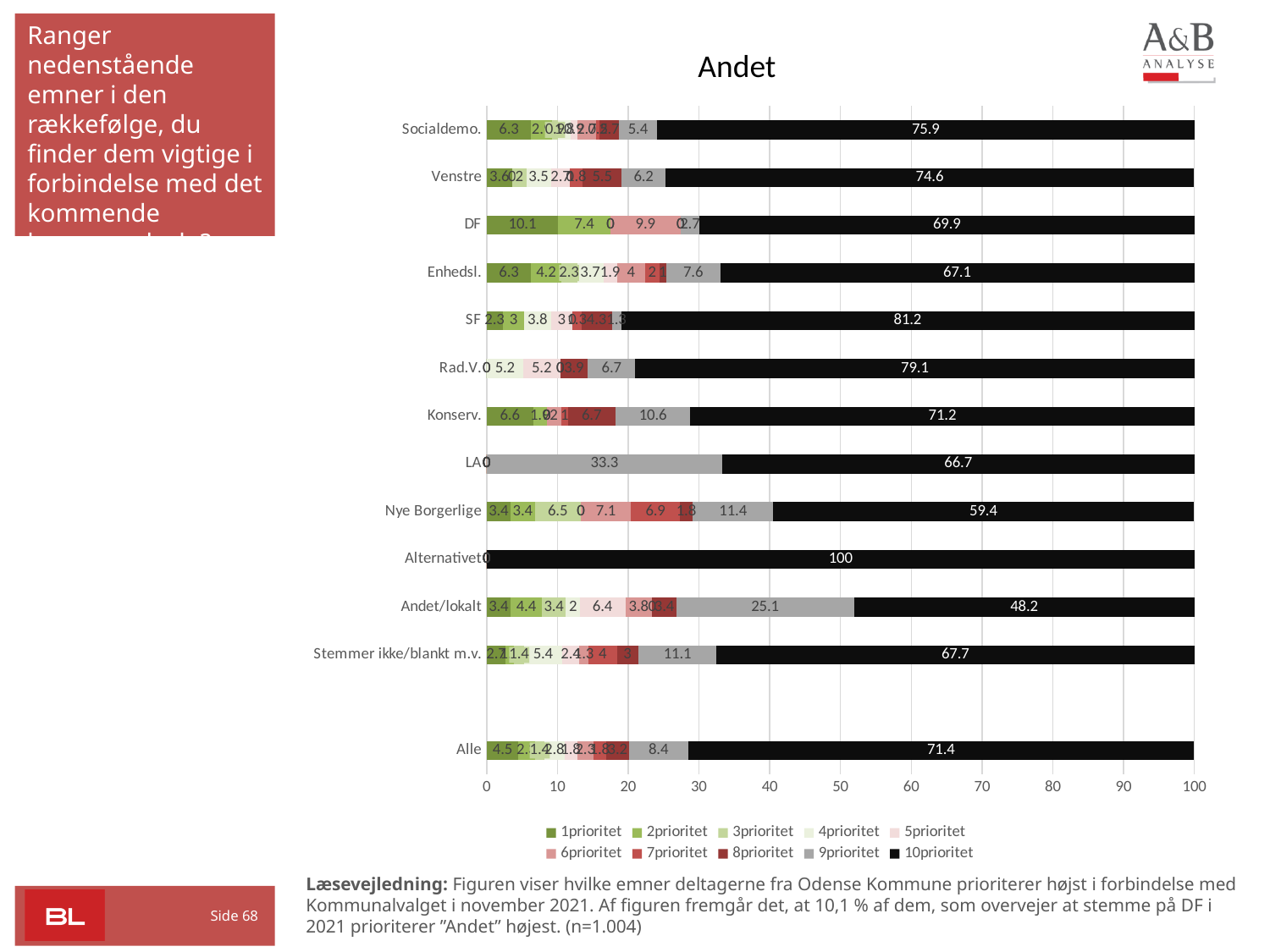
What is the 10prioritet value for Alle? 71.4 What kind of chart is shown on the slide? Stacked bar chart What is the 9prioritet value for LA? 33.3 Which category has the highest 10prioritet value? Alternativet Which category has the lowest 10prioritet value? Andet/lokalt How many series does the legend list? 10 What is the difference between the 10prioritet values for SF and Socialdemo.? 5.3 How many categories are plotted on the y axis? 13 What is the 1prioritet value for DF? 10.1 Which has the larger 10prioritet value, Venstre or DF? Venstre What is the 10prioritet value for Alternativet? 100 What is the title of the chart? Andet